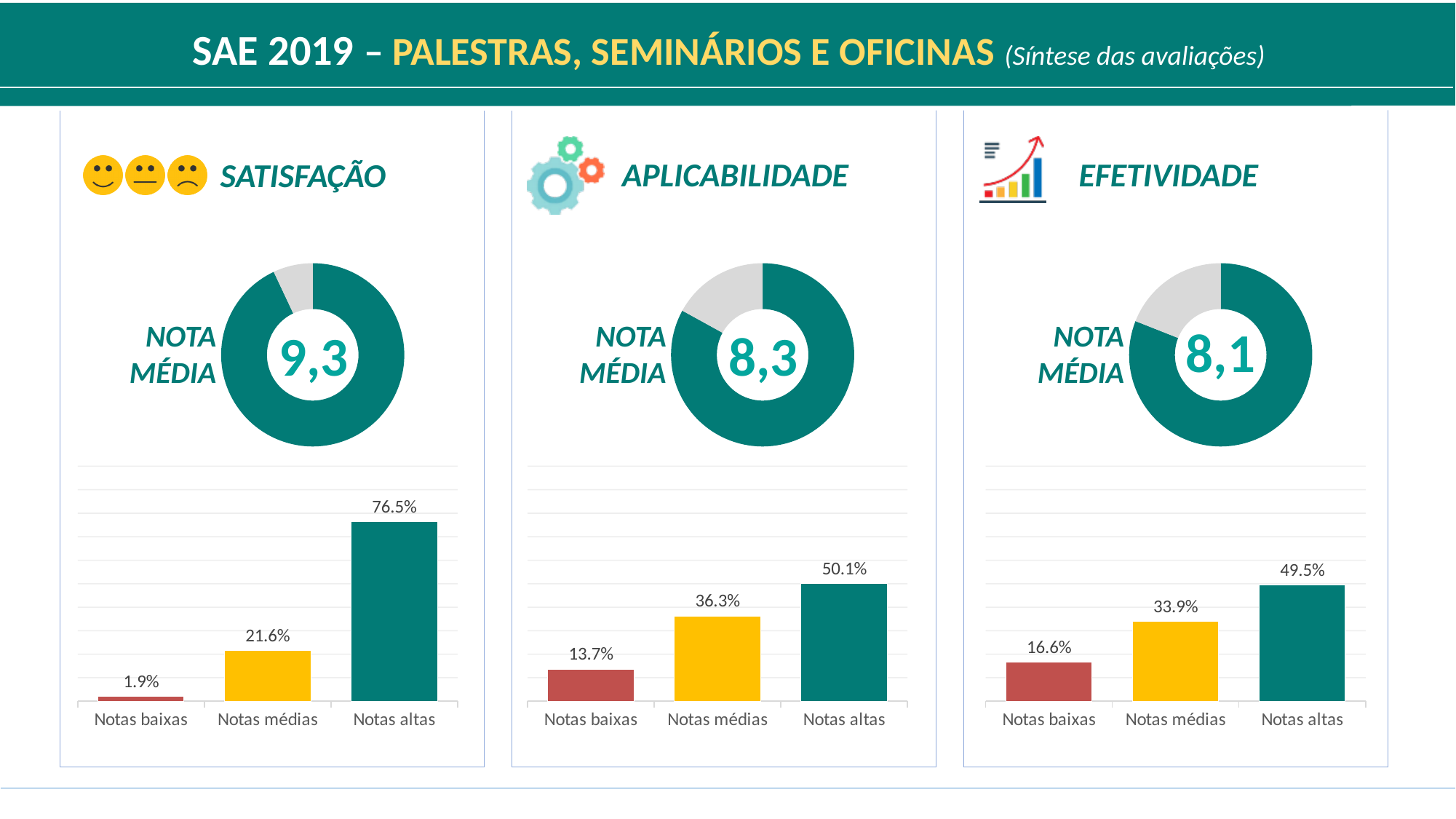
In the EFETIVIDADE bar chart, which is larger, Notas médias or Notas baixas? Notas médias What kind of chart is shown below the NOTA MÉDIA donut in the EFETIVIDADE panel? Bar chart In the SATISFAÇÃO bar chart, do the values rise or fall from Notas baixas to Notas altas? Rise In the APLICABILIDADE bar chart, what is the difference between Notas altas and Notas baixas? 36.4% What is the NOTA MÉDIA shown in the APLICABILIDADE donut chart? 8,3 In the SATISFAÇÃO bar chart, what is the value for Notas altas? 76.5% How many categories does the APLICABILIDADE bar chart show? 3 In the EFETIVIDADE bar chart, what is the value for Notas baixas? 16.6% In the EFETIVIDADE bar chart, which category has the highest value? Notas altas In the SATISFAÇÃO bar chart, what is the difference between Notas altas and Notas médias? 54.9% In the APLICABILIDADE bar chart, what is the value for Notas médias? 36.3% In the SATISFAÇÃO bar chart, which category has the lowest value? Notas baixas